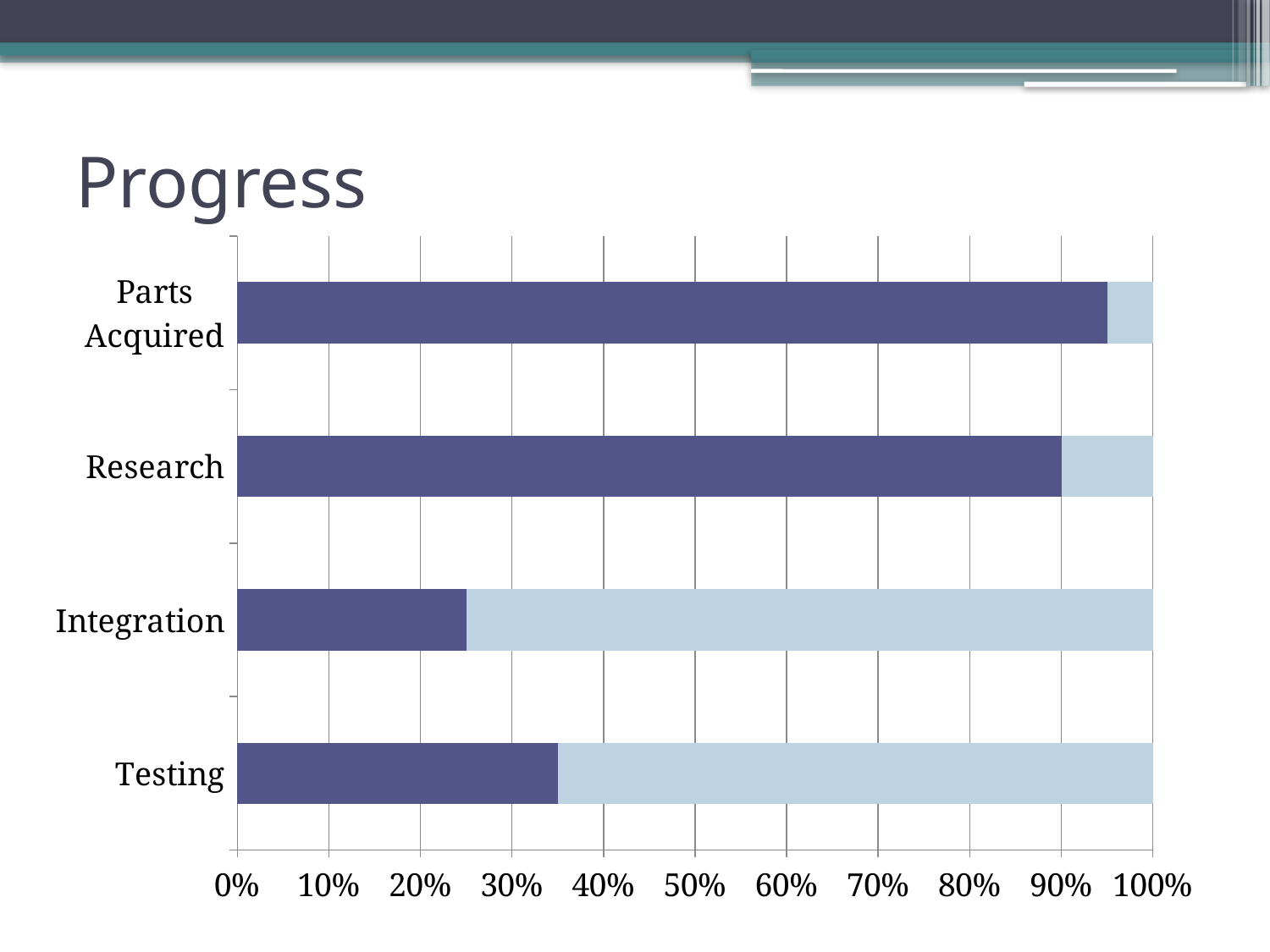
What is the title of the slide containing the chart? Progress Which category has the longest dark segment? Parts Acquired How many categories are shown on the chart? 4 Is the dark segment for Testing greater or less than 40%? less What kind of chart is shown on the slide? bar chart What is the value of the dark segment for Research? 90% What is the total length of the stacked bar for Integration? 100% Which category has the shortest dark segment? Integration Is the dark segment for Integration greater or less than 30%? less Is the dark segment for Parts Acquired greater or less than 90%? greater Which has a longer dark segment, Testing or Integration? Testing